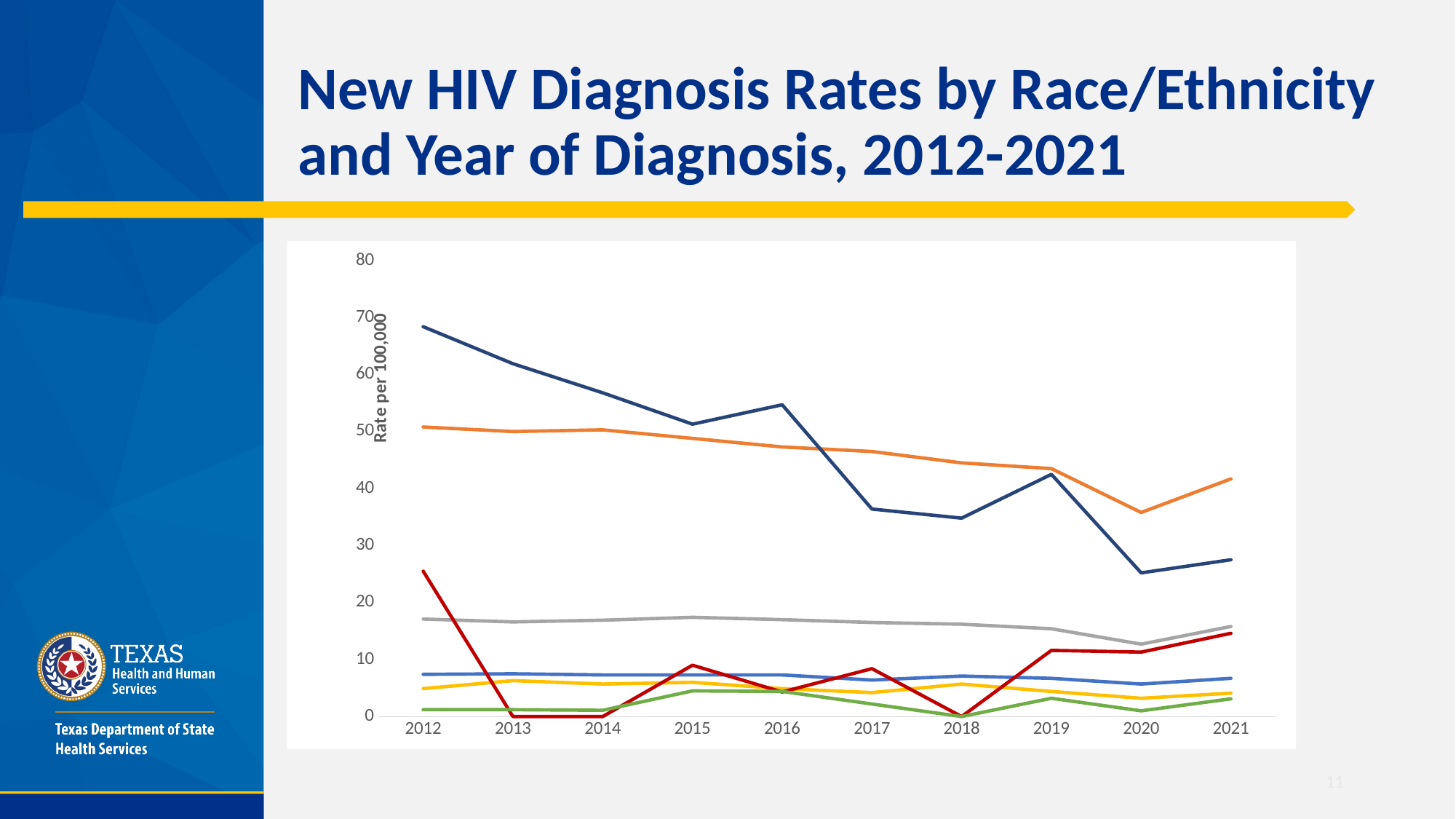
In 2021, which line is higher: the orange line or the dark blue line? orange line What kind of chart is shown on the slide? line chart What is the label on the y axis of the chart? Rate per 100,000 Is the value of the grey line in 2015 greater or less than 20? less Is the value of the red line in 2012 greater or less than 20? greater How many lines are plotted on the chart? 7 Does the dark blue line rise or fall overall from 2012 to 2021? fall What is the title of the chart slide? New HIV Diagnosis Rates by Race/Ethnicity and Year of Diagnosis, 2012-2021 Is the value of the orange line in 2020 greater or less than 40? less How many years are shown along the x axis of the chart? 10 In which year does the dark blue line reach its highest value? 2012